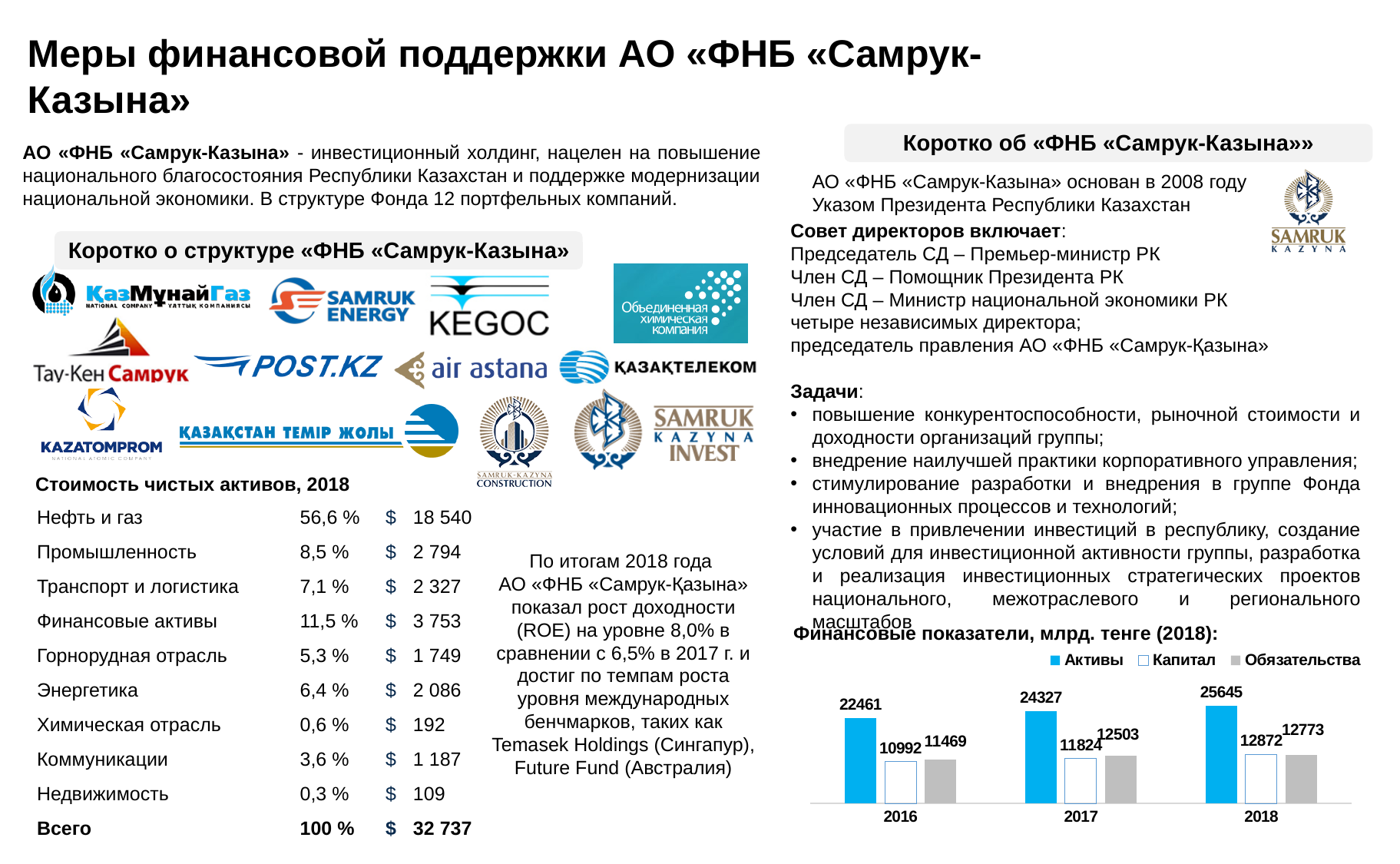
In the "Финансовые показатели" chart, what is the difference between Активы in 2018 and Активы in 2016? 3184 In the "Финансовые показатели" chart, which series is shown in grey? Обязательства How many years are shown on the x axis of the "Финансовые показатели" chart? 3 In the "Финансовые показатели" chart, what is the value of Активы for 2018? 25645 How many series does the legend of the "Финансовые показатели" chart list? 3 In the "Финансовые показатели" chart, what is the value of Капитал for 2016? 10992 In the "Финансовые показатели" chart, what is the value of Обязательства for 2017? 12503 In the "Финансовые показатели" chart, which year has the lowest value of Капитал? 2016 What kind of chart is shown under "Финансовые показатели, млрд. тенге (2018)"? bar chart In the "Финансовые показатели" chart, do the values of Активы rise or fall from 2016 to 2018? rise In the "Финансовые показатели" chart, which is larger in 2017: Капитал or Обязательства? Обязательства In the "Финансовые показатели" chart, which year has the highest value of Активы? 2018